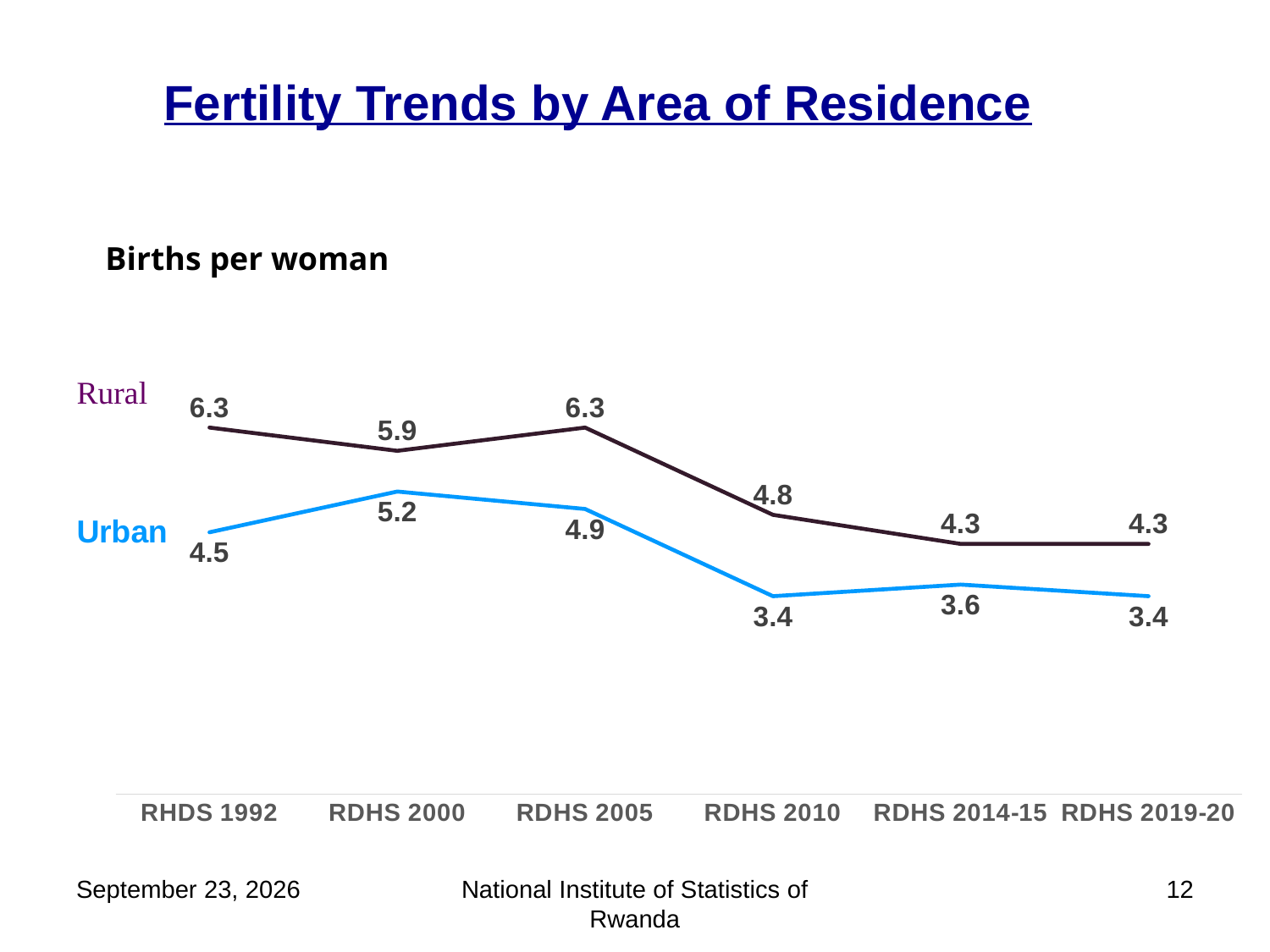
What is the Rural value for RDHS 2000? 5.9 How many series are plotted on the chart? 2 What is the difference between the Rural values for RDHS 2005 and RDHS 2010? 1.5 Which survey has the lowest Rural value? RDHS 2014-15 and RDHS 2019-20 What is the Urban value for RDHS 2014-15? 3.6 What is the Rural value for RDHS 2010? 4.8 What kind of chart is shown on the slide? line chart How many surveys are shown on the x axis? 6 What is the Urban value for RHDS 1992? 4.5 Which is larger, the Urban value for RDHS 2000 or the Urban value for RDHS 2005? RDHS 2000 Which survey has the highest Urban value? RDHS 2000 What is the difference between the Rural and Urban values for RDHS 2019-20? 0.9